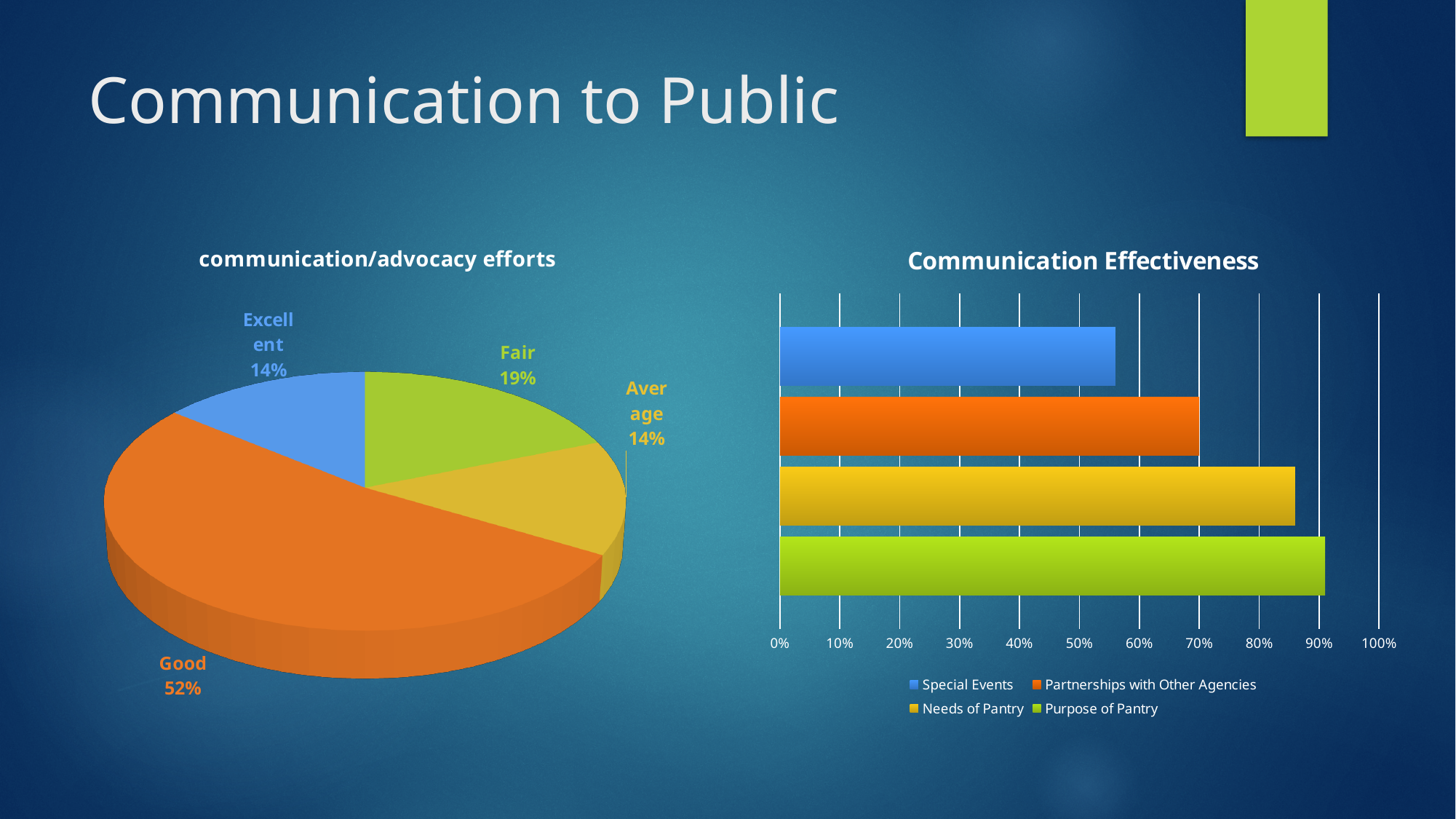
In the 'Communication Effectiveness' chart, is the value for Needs of Pantry greater or less than 80%? greater In the 'communication/advocacy efforts' pie chart, what share does Fair have? 19% In the 'communication/advocacy efforts' pie chart, how many slices are there? 4 In the 'communication/advocacy efforts' pie chart, which is larger, Fair or Average? Fair In the 'communication/advocacy efforts' pie chart, what share does Good have? 52% In the 'Communication Effectiveness' chart, which series has the shortest bar? Special Events What kind of chart is 'Communication Effectiveness'? Bar chart In the 'communication/advocacy efforts' pie chart, which category has the largest slice? Good In the 'Communication Effectiveness' chart, is the value for Special Events greater or less than 60%? less In the 'Communication Effectiveness' chart, which series has the longest bar? Purpose of Pantry How many series does the legend of the 'Communication Effectiveness' chart list? 4 In the 'communication/advocacy efforts' pie chart, what is the difference between the Good and Fair shares? 33%